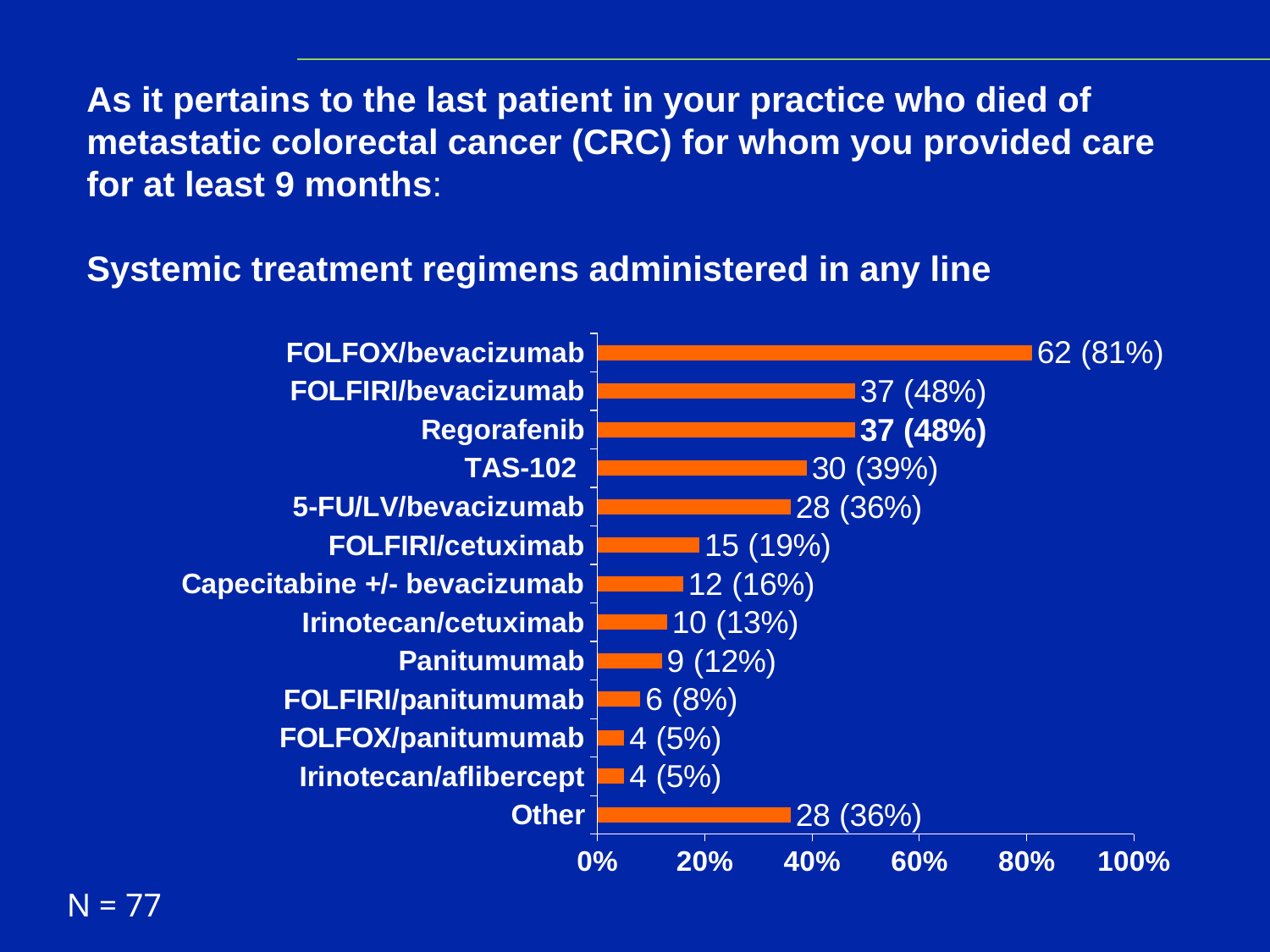
What is the sample size (N) stated on the slide? N = 77 What is the difference in number of patients between TAS-102 and FOLFIRI/cetuximab? 15 What is the value shown for TAS-102? 30 (39%) What kind of chart is shown on the slide? Bar chart Which regimen has the highest value? FOLFOX/bevacizumab How many regimen categories are shown on the chart? 13 What is the value shown for Capecitabine +/- bevacizumab? 12 (16%) What is the title of the chart? Systemic treatment regimens administered in any line What is the difference in percentage points between FOLFOX/bevacizumab and FOLFIRI/bevacizumab? 33 percentage points What is the value shown for FOLFOX/bevacizumab? 62 (81%) Is the value for Regorafenib greater or less than 40%? greater Which is larger, the value for 5-FU/LV/bevacizumab or the value for Panitumumab? 5-FU/LV/bevacizumab